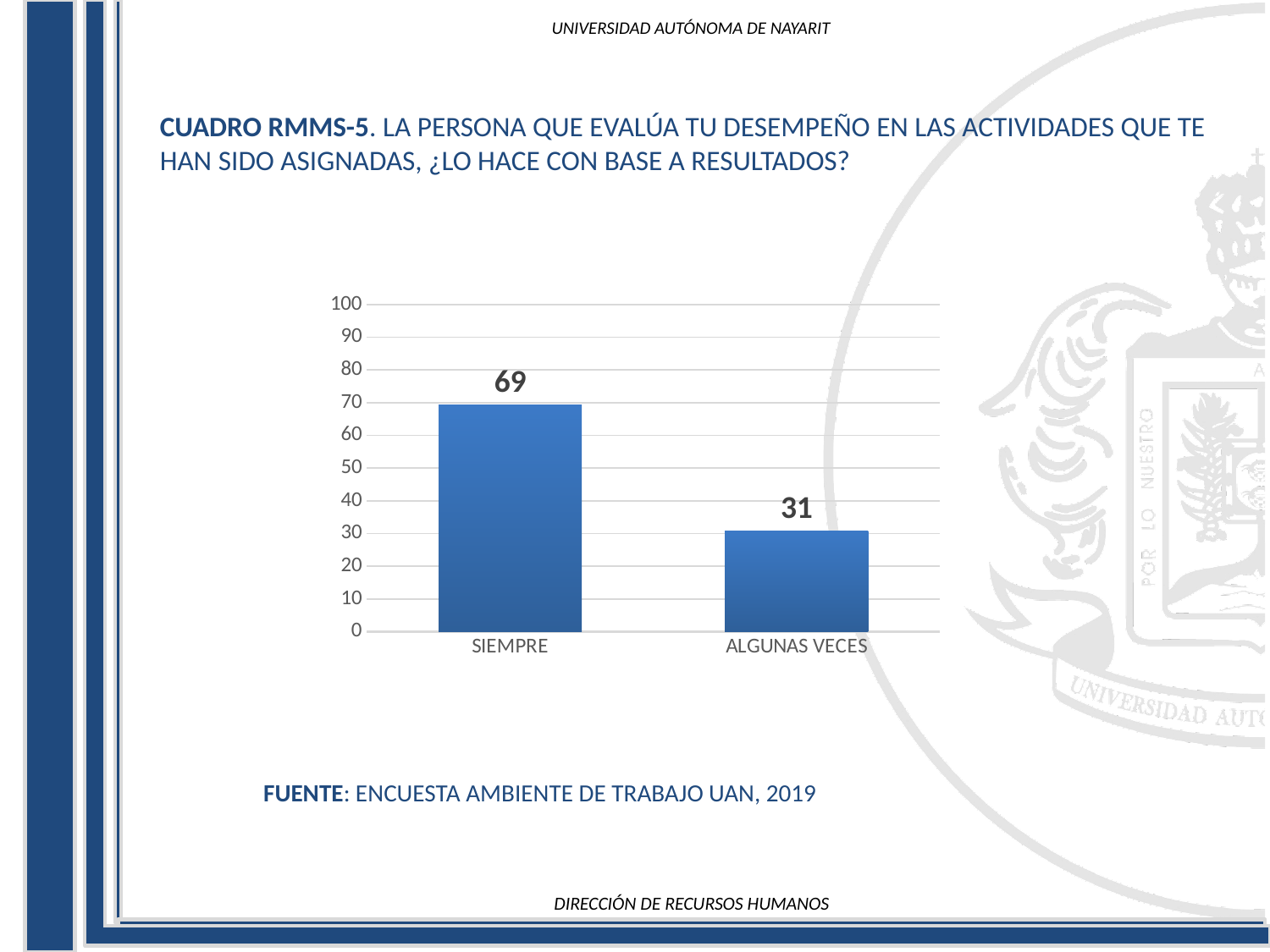
What is the total of the two values shown in the chart? 100 Which category has the lowest value? ALGUNAS VECES What is the maximum value shown on the vertical axis? 100 Which category has the highest value? SIEMPRE Is the value for ALGUNAS VECES greater or less than 40? less What is the difference between the values for SIEMPRE and ALGUNAS VECES? 38 What is the value for SIEMPRE? 69 What is the value for ALGUNAS VECES? 31 Is the value for SIEMPRE greater or less than 60? greater Which is larger, the value for SIEMPRE or the value for ALGUNAS VECES? SIEMPRE How many categories are shown on the x axis? 2 What kind of chart is shown on the slide? bar chart